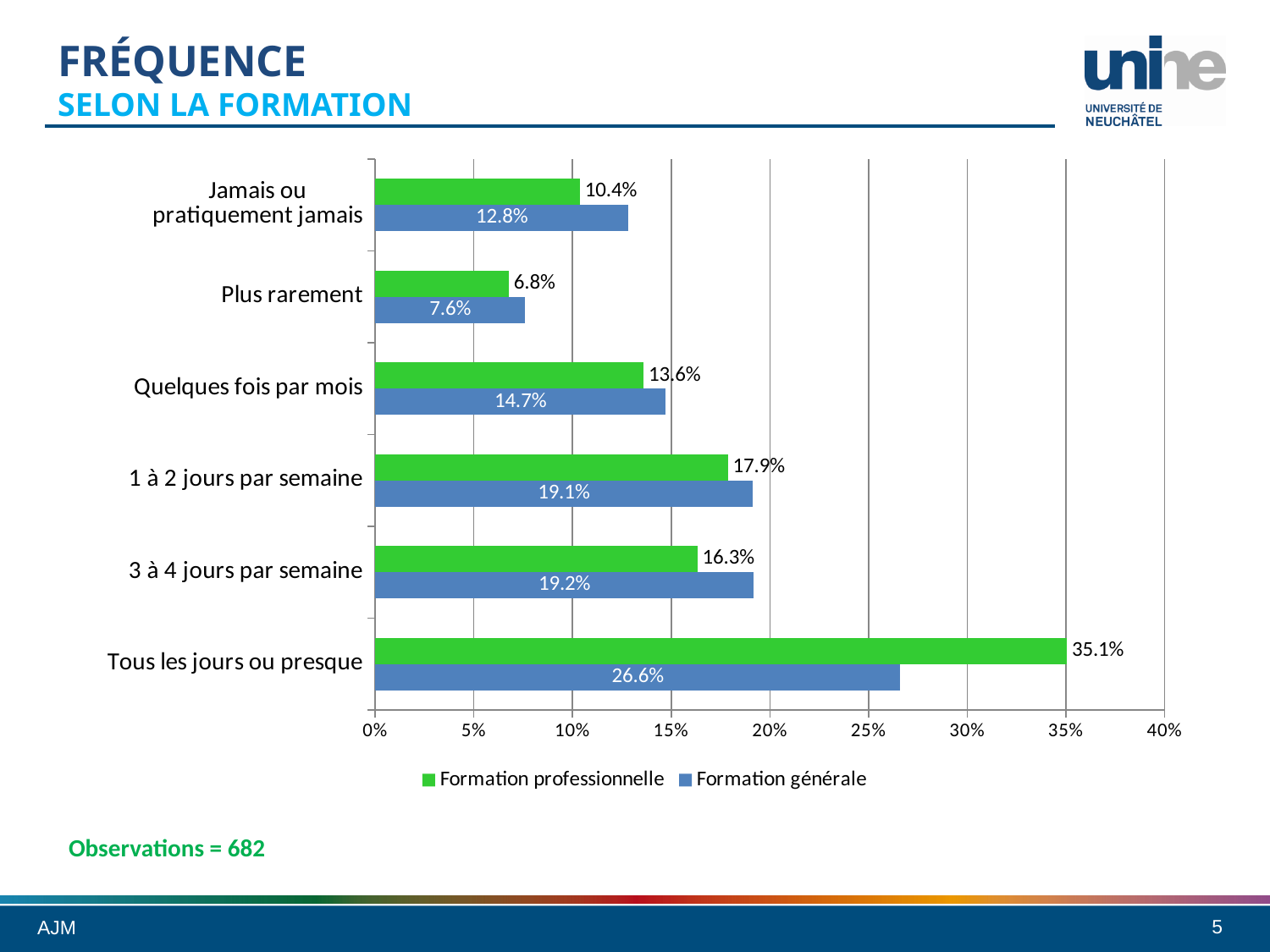
Which is larger in the '3 à 4 jours par semaine' category: Formation professionnelle or Formation générale? Formation générale Which category has the highest value for Formation professionnelle? Tous les jours ou presque What is the difference between Formation professionnelle and Formation générale in the 'Tous les jours ou presque' category? 8.5% What kind of chart is shown on the slide? bar chart Is the value for Formation générale in 'Quelques fois par mois' greater or less than 10%? greater What is the value for Formation générale in the 'Jamais ou pratiquement jamais' category? 12.8% How many series does the legend list? 2 How many categories are shown on the chart? 6 What is the value for Formation professionnelle in the 'Tous les jours ou presque' category? 35.1% What is the value for Formation générale in the 'Plus rarement' category? 7.6% Which colour represents Formation professionnelle in the chart? green Which category has the lowest value for Formation générale? Plus rarement